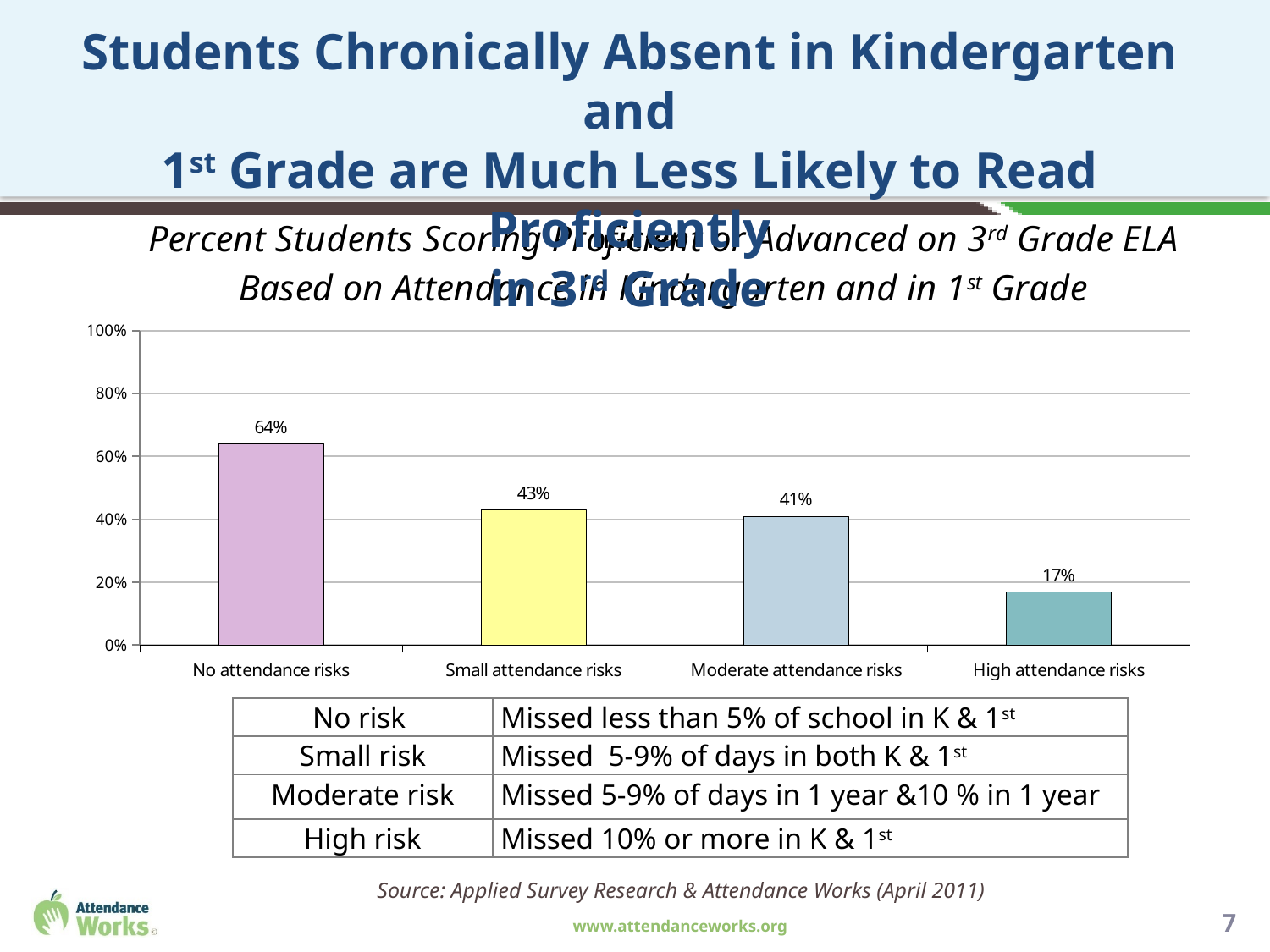
Do the values rise or fall moving from No attendance risks to High attendance risks along the x axis? Fall What is the value shown for the Moderate attendance risks bar? 41% What is the difference in percentage points between the Small attendance risks bar and the Moderate attendance risks bar? 2 What is the value shown for the High attendance risks bar? 17% How many attendance risk categories are shown on the x axis of the chart? 4 Which attendance risk category has the highest percent of students scoring proficient or advanced? No attendance risks What is the value shown for the Small attendance risks bar? 43% What kind of chart is shown on the slide? Bar chart What is the difference in percentage points between the No attendance risks bar and the High attendance risks bar? 47 Which is larger, the value for No attendance risks or the value for Small attendance risks? No attendance risks What percent of students with no attendance risks scored proficient or advanced on 3rd grade ELA? 64% Which attendance risk category has the lowest percent of students scoring proficient or advanced? High attendance risks